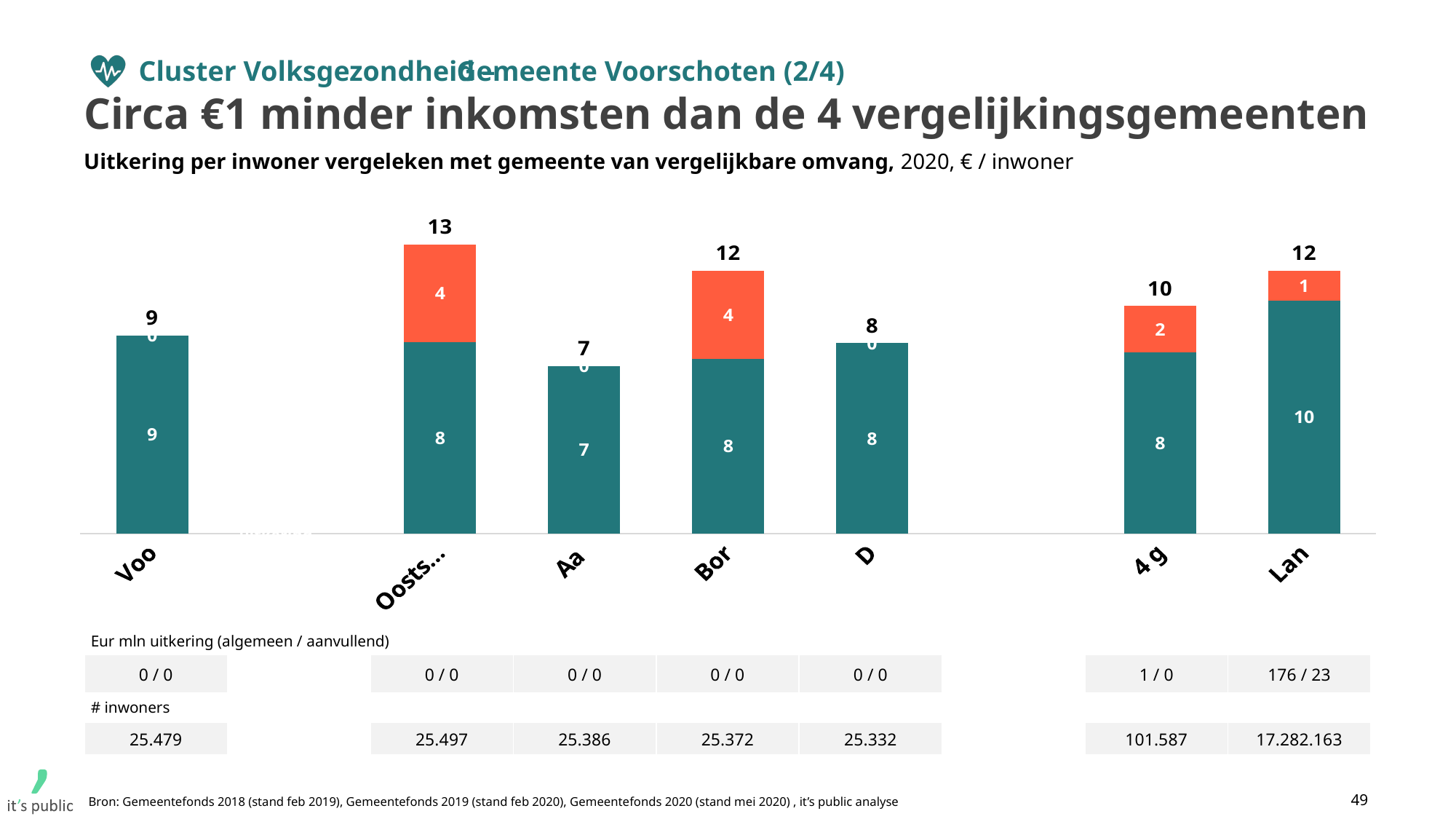
What is the value of the orange (top) segment for 4 g? 2 What is the difference between the total for Oosts... and the total for Voo? 4 What is the total value of the bar for Oosts...? 13 What is the value of the teal (bottom) segment for Lan? 10 Which has a larger total bar value, Bor or D? Bor What is the total value of the bar for Voo? 9 How many bars are shown in the chart? 7 What is the unit stated in the chart subtitle? € / inwoner What is the value of the orange (top) segment for Bor? 4 Which category has the lowest total bar value? Aa What kind of chart is shown on the slide? Stacked bar chart Which category has the highest total bar value? Oosts...